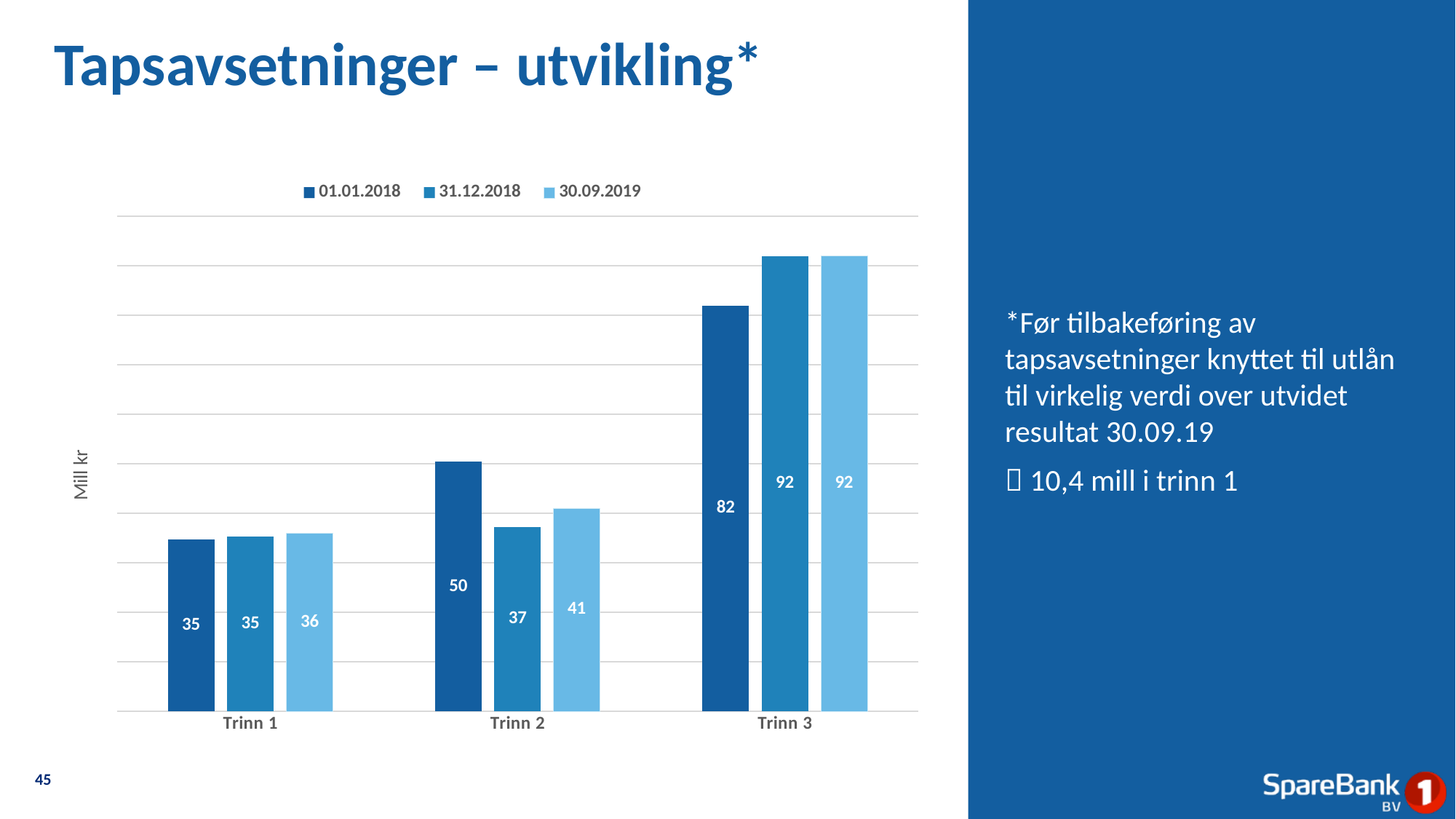
What is the label on the vertical axis? Mill kr How many series does the legend list? 3 What is the value for Trinn 1 in the 31.12.2018 series? 35 Which category has the lowest value in the 30.09.2019 series? Trinn 1 What is the value for Trinn 2 in the 01.01.2018 series? 50 How many categories are shown on the x axis? 3 What kind of chart is shown on the slide? Bar chart What is the value for Trinn 3 in the 30.09.2019 series? 92 Which is larger for Trinn 2: the 01.01.2018 value or the 31.12.2018 value? 01.01.2018 What is the difference between the 31.12.2018 and 01.01.2018 values for Trinn 3? 10 Which category has the highest value in the 01.01.2018 series? Trinn 3 What is the difference between the 01.01.2018 and 30.09.2019 values for Trinn 2? 9